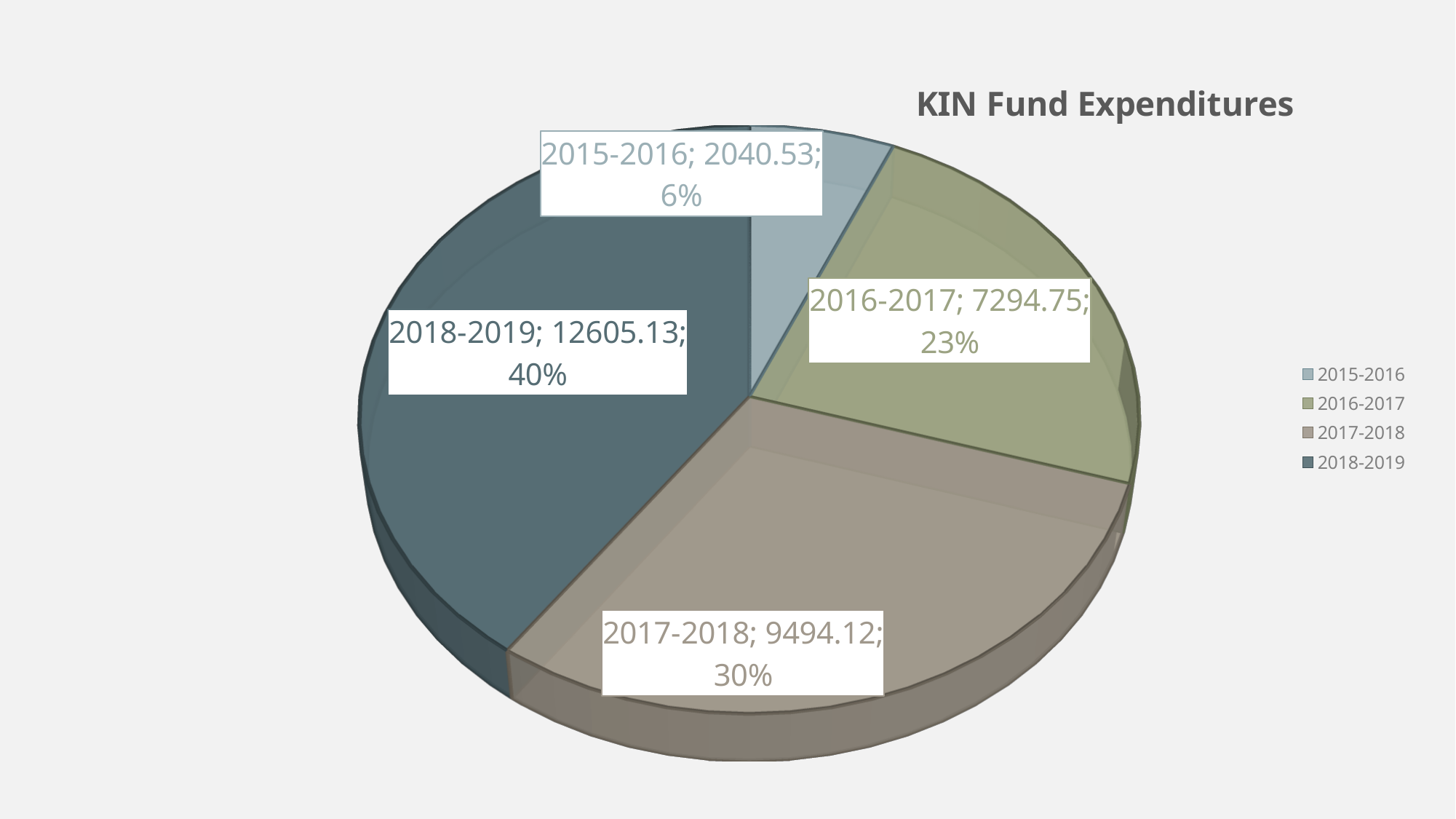
Which period has the highest expenditure in the KIN Fund Expenditures chart? 2018-2019 What is the title of the chart on the slide? KIN Fund Expenditures What is the value for 2017-2018 in the KIN Fund Expenditures chart? 9494.12 What is the value for 2015-2016 in the KIN Fund Expenditures chart? 2040.53 What percentage share does 2018-2019 have in the KIN Fund Expenditures pie? 40% What percentage share does 2016-2017 have in the KIN Fund Expenditures pie? 23% How many slices does the KIN Fund Expenditures pie chart have? 4 Which is larger in the KIN Fund Expenditures chart, the value for 2016-2017 or the value for 2017-2018? 2017-2018 What is the difference between the 2016-2017 and 2015-2016 values in the KIN Fund Expenditures chart? 5254.22 What is the difference between the 2018-2019 and 2017-2018 values in the KIN Fund Expenditures chart? 3111.01 Which period has the lowest expenditure in the KIN Fund Expenditures chart? 2015-2016 What type of chart is shown on the slide? Pie chart